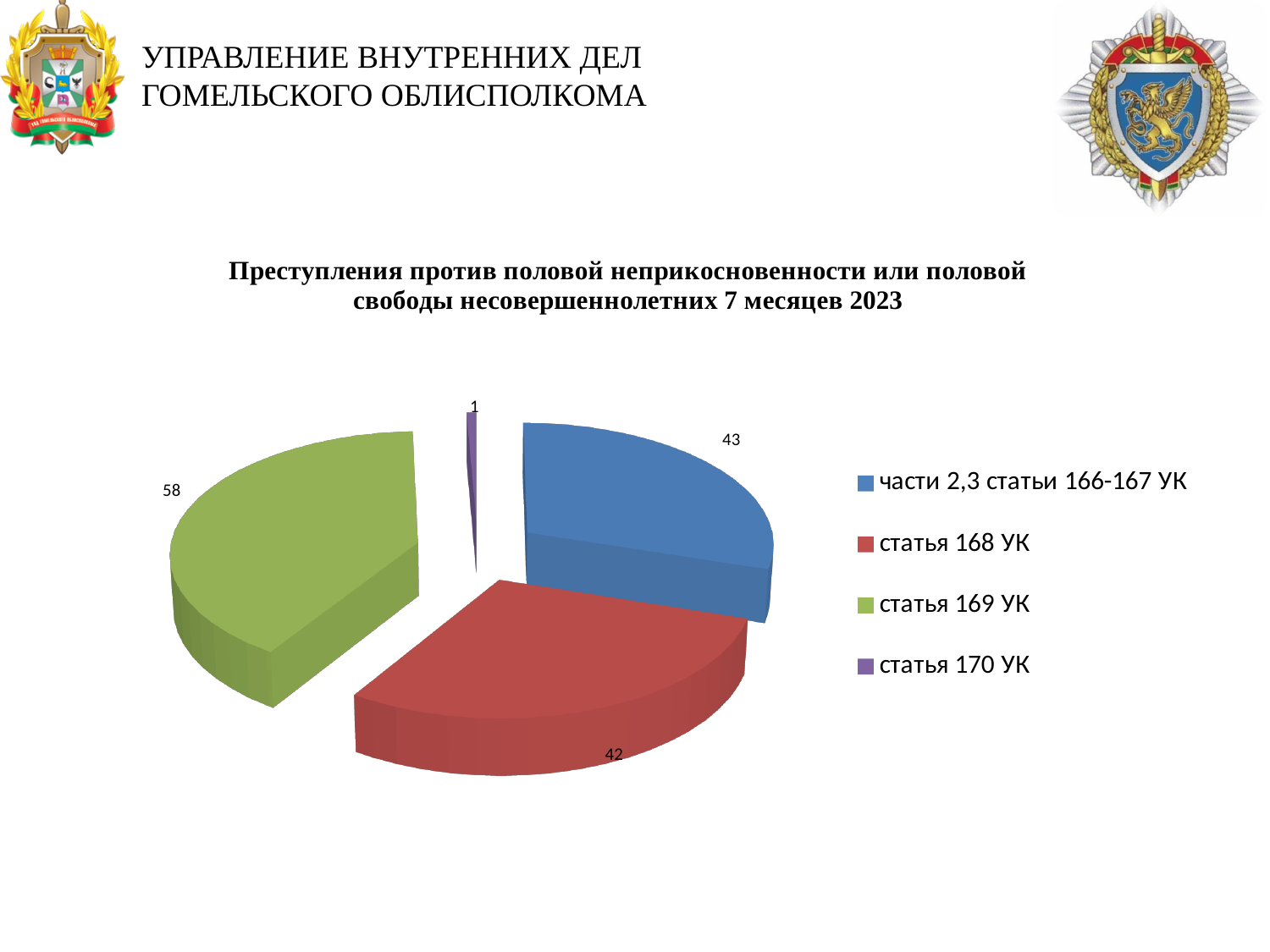
What is the value for статья 169 УК? 58 What is the difference between the values for статья 169 УК and статья 168 УК? 16 What type of chart is shown on the slide? pie chart What is the value for статья 168 УК? 42 Which category has the largest slice of the pie? статья 169 УК What colour is the slice for статья 168 УК? red What is the total of all the values shown in the pie chart? 144 Which category has the smallest slice of the pie? статья 170 УК How many categories does the pie chart have? 4 What is the value for части 2,3 статьи 166-167 УК? 43 What is the value for статья 170 УК? 1 Which is larger: the value for статья 169 УК or the value for части 2,3 статьи 166-167 УК? статья 169 УК